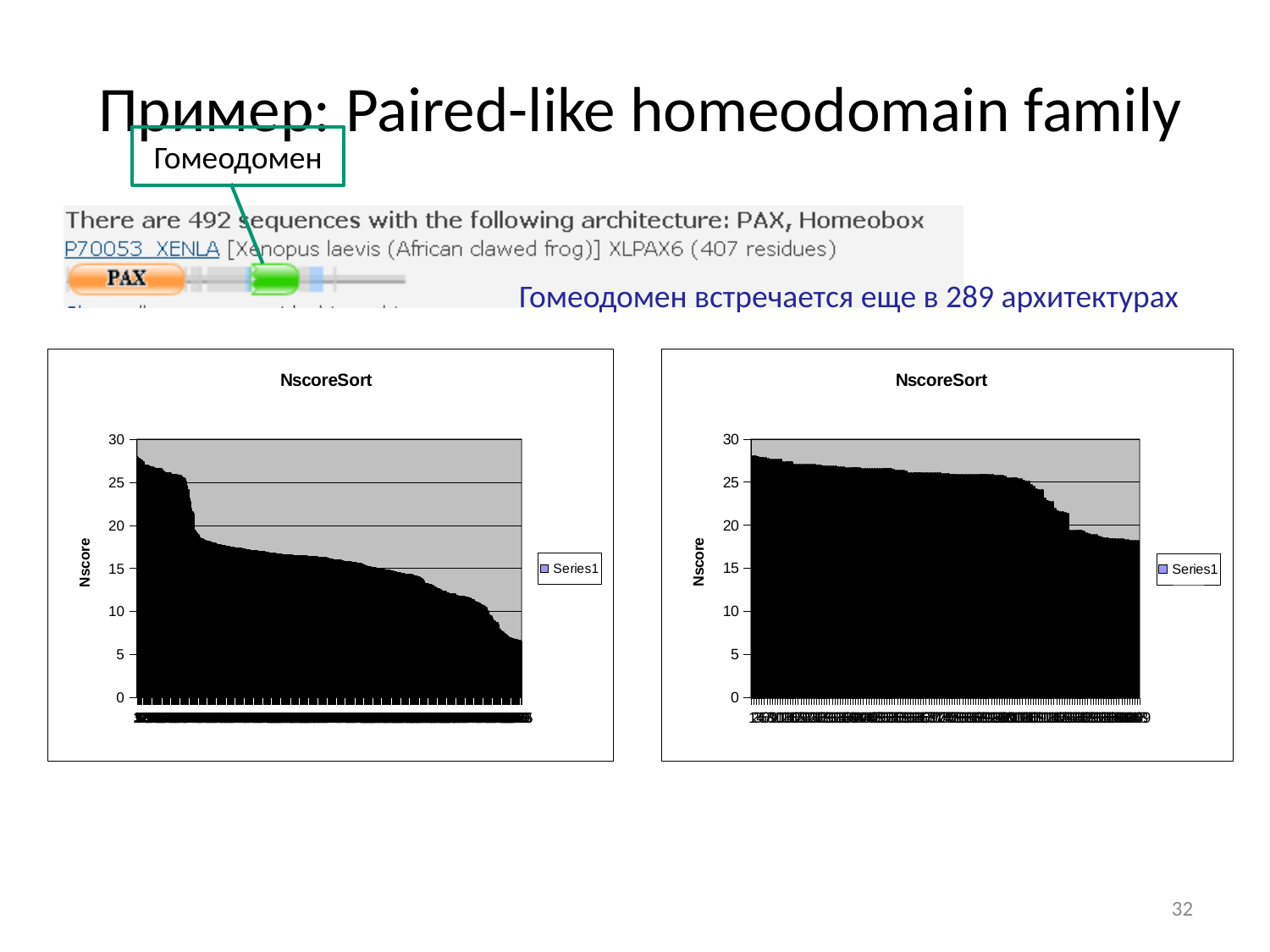
In the right chart, is the value of the first (leftmost) bar greater or less than 25? greater In the left chart, is the value of the first (leftmost) bar greater or less than 25? greater What is the label on the y axis of the right chart? Nscore How many series does the legend of the right chart list? 1 In the left chart, is the value of the last (rightmost) bar greater or less than 10? less How many series does the legend of the left chart list? 1 In the right chart, do the values rise or fall from left to right along the x axis? fall What kind of chart is the right chart on the slide? bar chart What kind of chart is the left chart on the slide? bar chart In the left chart, do the values rise or fall from left to right along the x axis? fall What is the title of the left chart? NscoreSort